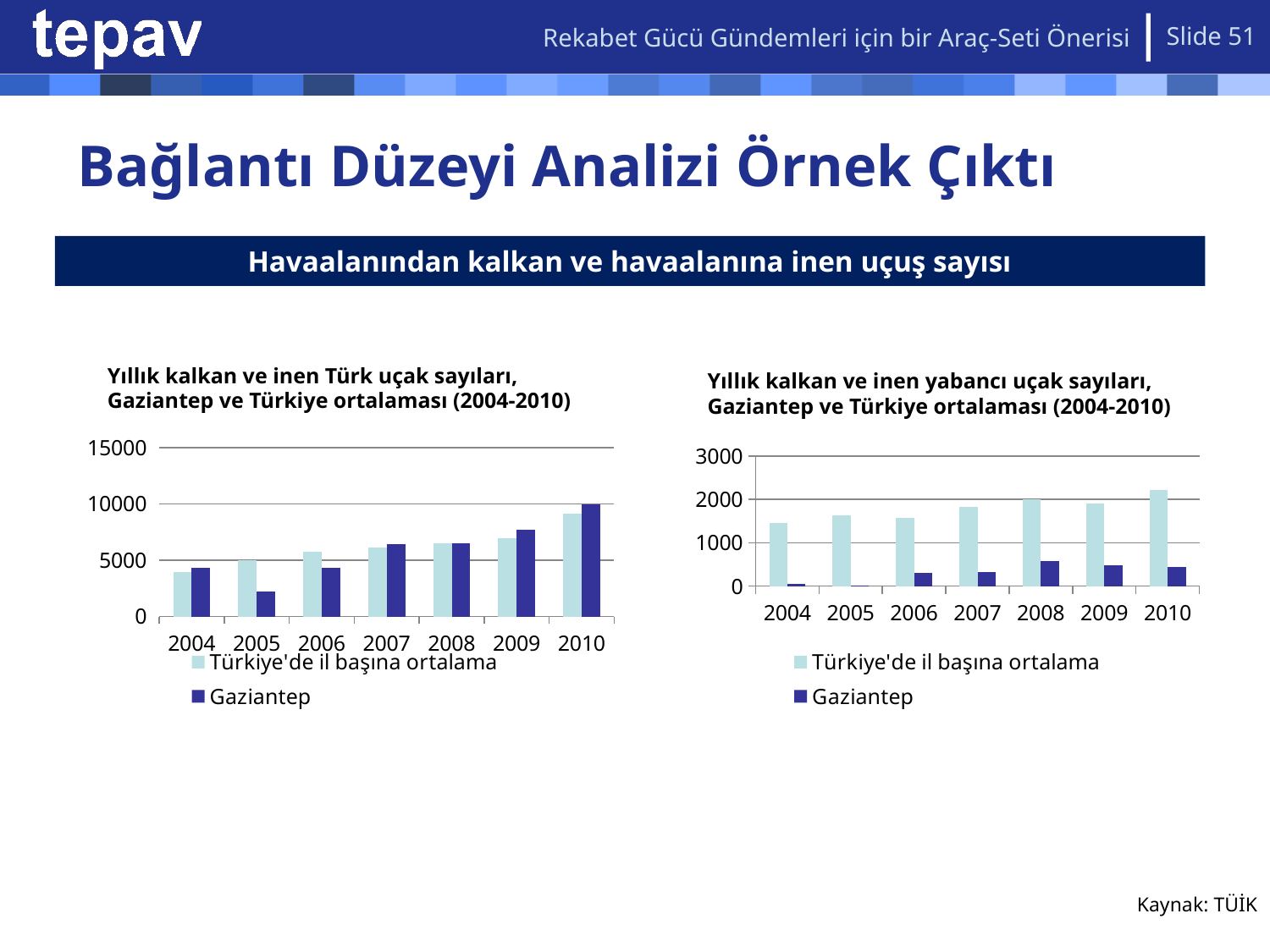
In the right chart, 'Yıllık kalkan ve inen yabancı uçak sayıları', which is larger in 2007: Türkiye'de il başına ortalama or Gaziantep? Türkiye'de il başına ortalama How many years are shown on the x axis of the left chart, 'Yıllık kalkan ve inen Türk uçak sayıları'? 7 In the right chart, 'Yıllık kalkan ve inen yabancı uçak sayıları', is the Türkiye'de il başına ortalama value for 2010 greater or less than 2000? greater How many series does the legend of the right chart, 'Yıllık kalkan ve inen yabancı uçak sayıları', list? 2 In the left chart, 'Yıllık kalkan ve inen Türk uçak sayıları', is the Gaziantep value for 2009 greater or less than 5000? greater What kind of chart is the left chart, 'Yıllık kalkan ve inen Türk uçak sayıları'? bar chart In the right chart, 'Yıllık kalkan ve inen yabancı uçak sayıları', is the Gaziantep value for 2008 greater or less than 1000? less In the left chart, 'Yıllık kalkan ve inen Türk uçak sayıları', which year has the lowest Gaziantep value? 2005 In the left chart, 'Yıllık kalkan ve inen Türk uçak sayıları', does the Türkiye'de il başına ortalama series rise or fall from 2004 to 2010? rise In the left chart, 'Yıllık kalkan ve inen Türk uçak sayıları', which year has the highest Türkiye'de il başına ortalama value? 2010 In the right chart, 'Yıllık kalkan ve inen yabancı uçak sayıları', which year has the highest Türkiye'de il başına ortalama value? 2010